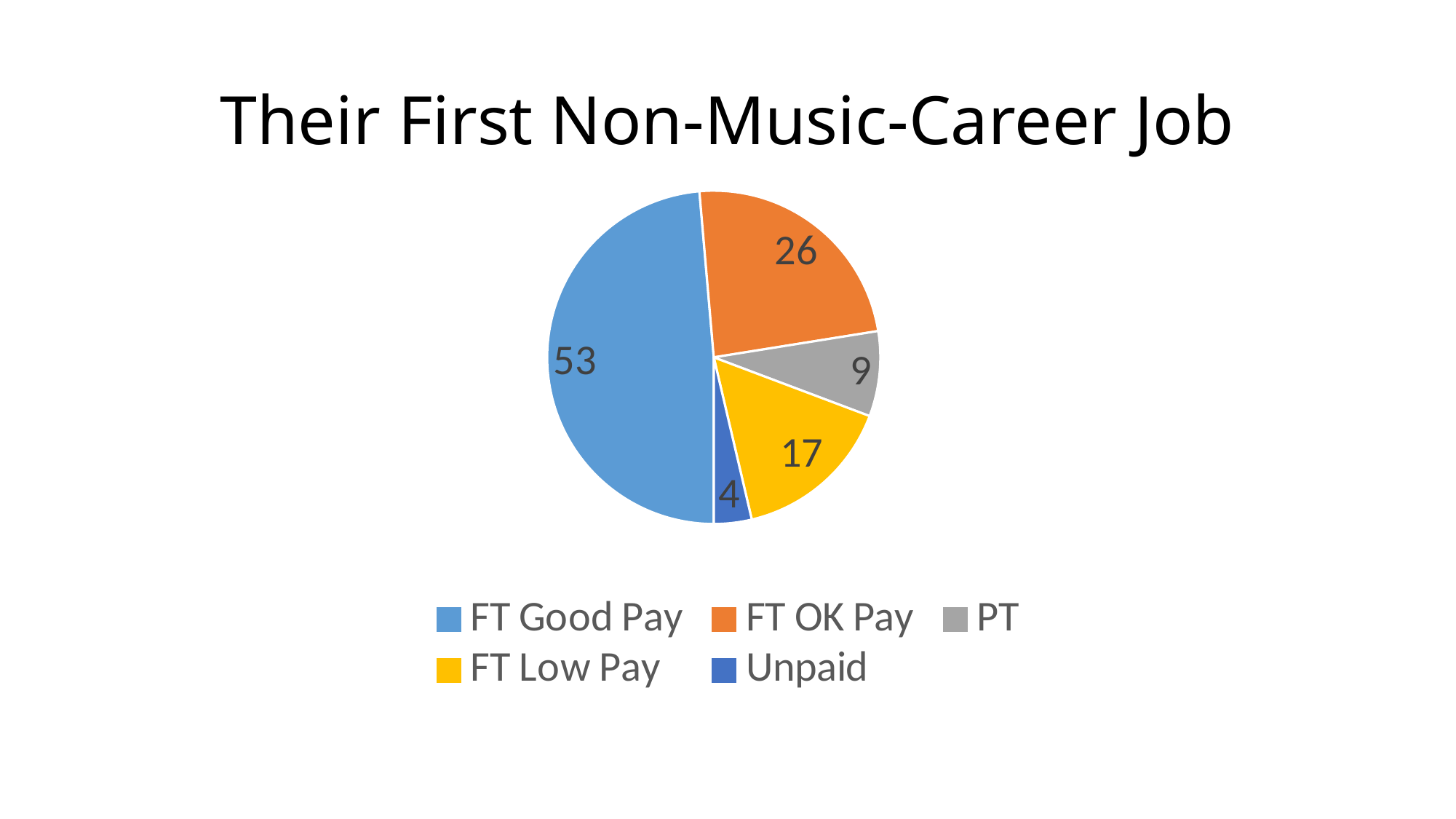
What is the title of the chart? Their First Non-Music-Career Job What is the value for PT? 9 How many categories does the pie chart show? 5 Which is larger, the value for FT Low Pay or the value for PT? FT Low Pay What is the difference between the values for FT Low Pay and PT? 8 Which category has the largest slice of the pie? FT Good Pay What is the value for FT OK Pay? 26 What is the value for FT Good Pay? 53 Which category has the smallest slice of the pie? Unpaid What kind of chart is shown on the slide? Pie chart What is the difference between the values for FT Good Pay and FT OK Pay? 27 What is the value for Unpaid? 4